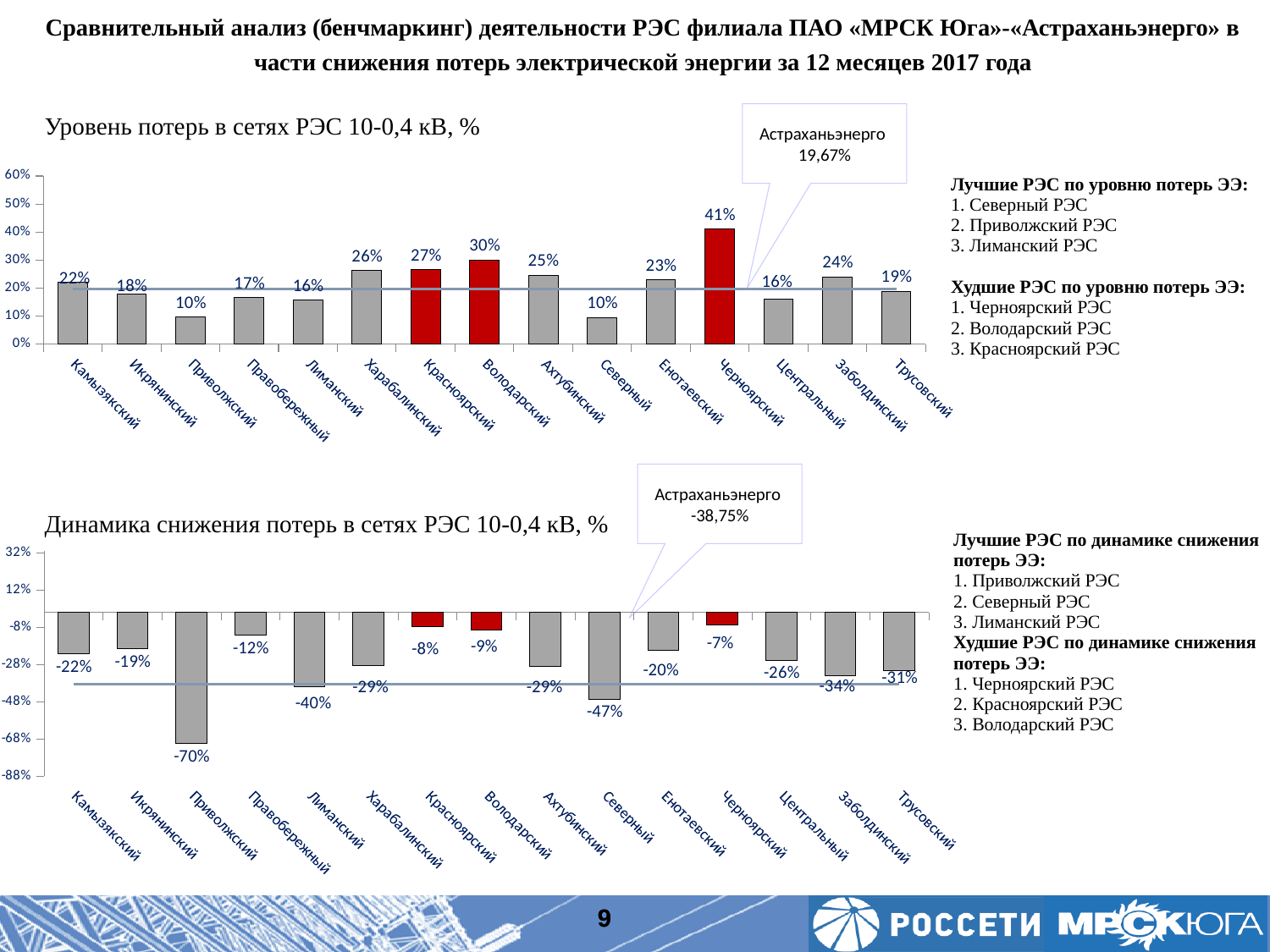
In the chart 'Уровень потерь в сетях РЭС 10-0,4 кВ, %', which category has the highest value? Черноярский In the chart 'Динамика снижения потерь в сетях РЭС 10-0,4 кВ, %', which category has the lowest value? Приволжский What kind of chart is 'Уровень потерь в сетях РЭС 10-0,4 кВ, %'? Bar chart In the chart 'Динамика снижения потерь в сетях РЭС 10-0,4 кВ, %', which category has the highest value? Черноярский How many categories are shown in the chart 'Уровень потерь в сетях РЭС 10-0,4 кВ, %'? 15 In the chart 'Динамика снижения потерь в сетях РЭС 10-0,4 кВ, %', what is the value for Приволжский? -70% In the chart 'Динамика снижения потерь в сетях РЭС 10-0,4 кВ, %', what is the value for Заболдинский? -34% In the chart 'Уровень потерь в сетях РЭС 10-0,4 кВ, %', which is larger, the value for Харабалинский or the value for Ахтубинский? Харабалинский In the chart 'Уровень потерь в сетях РЭС 10-0,4 кВ, %', what is the difference between the values for Черноярский and Красноярский? 14% In the top chart, what value does the callout give for Астраханьэнерго? 19,67% In the chart 'Динамика снижения потерь в сетях РЭС 10-0,4 кВ, %', what is the difference between the values for Северный and Лиманский? 7% In the chart 'Уровень потерь в сетях РЭС 10-0,4 кВ, %', what is the value for Володарский? 30%